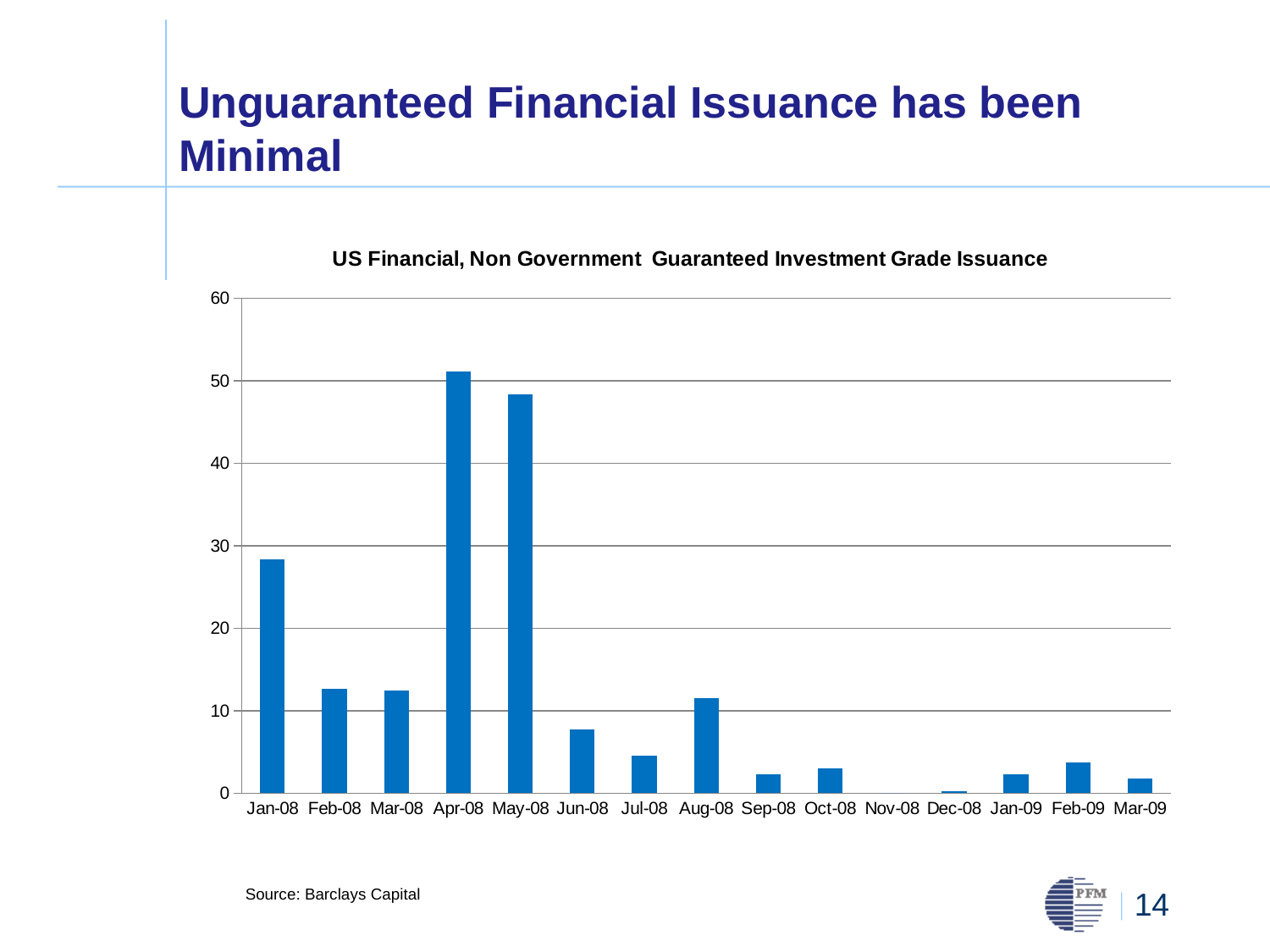
Is the value for Jan-08 greater or less than 30? less Is the value for Jun-08 greater or less than 10? less What is the title of the chart? US Financial, Non Government Guaranteed Investment Grade Issuance Which month has the highest issuance in the chart? Apr-08 Is the value for Apr-08 greater or less than 40? greater How many months are shown on the x axis of the chart? 15 Which is larger, the value for Aug-08 or the value for Sep-08? Aug-08 Which month has the lowest issuance in the chart? Nov-08 What kind of chart is shown on the slide? Bar chart From Apr-08 to Jul-08, do the values rise or fall? fall Which is larger, the value for Jan-08 or the value for Feb-08? Jan-08